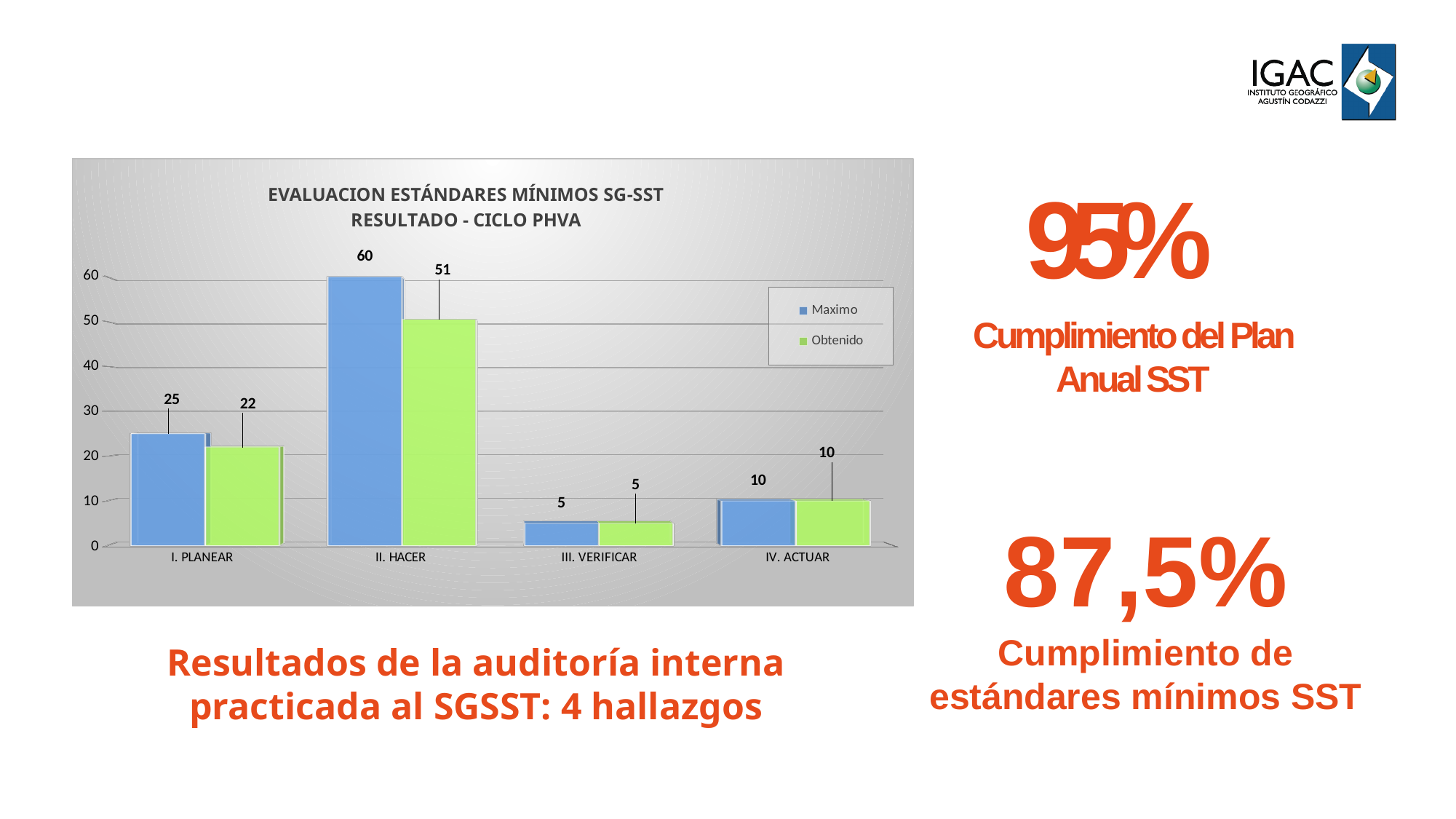
What is the Maximo value for II. HACER? 60 What is the Maximo value for IV. ACTUAR? 10 How many series does the legend list? 2 Which category has the lowest Obtenido value? III. VERIFICAR What is the Obtenido value for II. HACER? 51 Which is larger, the Obtenido value for I. PLANEAR or the Obtenido value for IV. ACTUAR? I. PLANEAR Which category has the highest Maximo value? II. HACER What is the Obtenido value for I. PLANEAR? 22 What is the difference between the Maximo and Obtenido values for I. PLANEAR? 3 How many categories are shown on the x axis? 4 What kind of chart is shown on the slide? Bar chart What is the difference between the Maximo and Obtenido values for II. HACER? 9